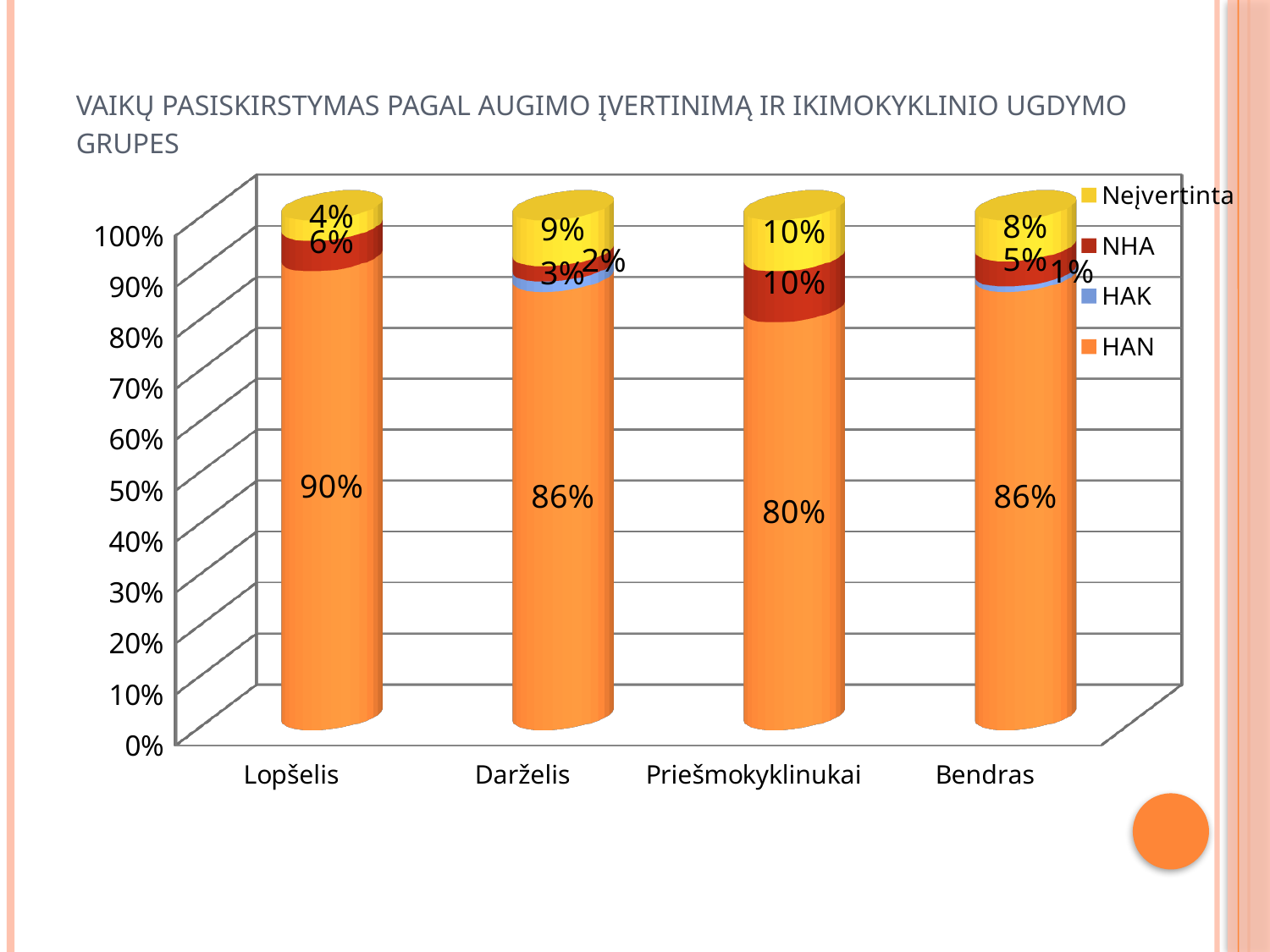
How many categories are shown on the x axis? 4 Which category has the highest HAN value? Lopšelis What is the HAN value for Priešmokyklinukai? 80% Which is larger, the Neįvertinta value for Darželis or for Lopšelis? Darželis How many series does the legend list? 4 What is the HAN value for Lopšelis? 90% What is the difference between the HAN value for Lopšelis and the HAN value for Priešmokyklinukai? 10 percentage points Which category has the lowest HAN value? Priešmokyklinukai What is the Neįvertinta value for Darželis? 9% What is the NHA value for Lopšelis? 6% What is the NHA value for Priešmokyklinukai? 10% What is the HAK value for Bendras? 1%